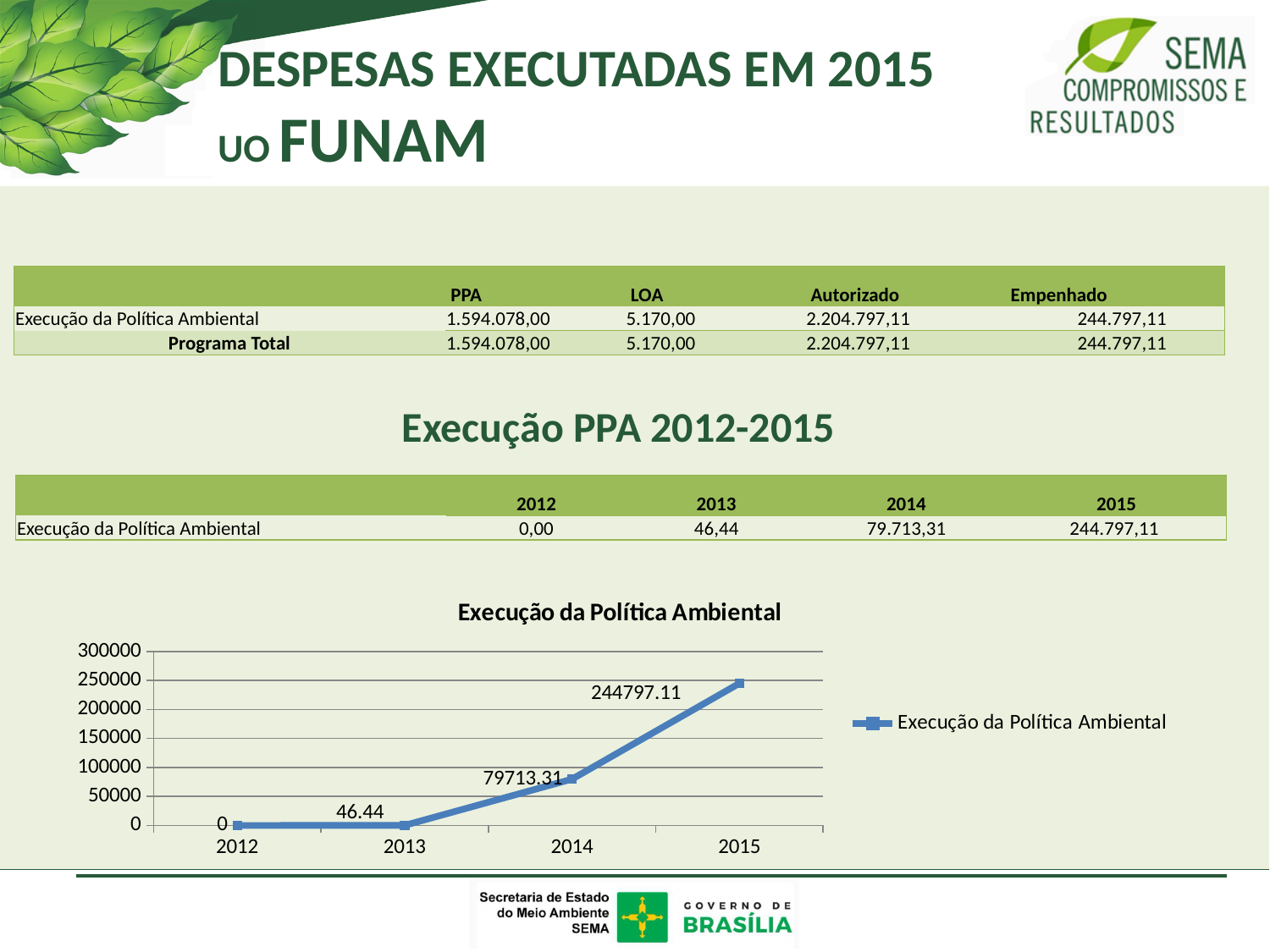
What kind of chart is shown on the slide? line chart How many years are plotted on the x axis of the chart? 4 How many series does the chart legend list? 1 Do the values in the chart rise or fall from 2012 to 2015? rise Is the value for 2015 greater or less than 200000? greater What is the value for 2013 in the chart? 46.44 Which year has the highest value in the chart? 2015 What is the value for 2014 in the chart? 79713.31 What is the value for 2015 in the chart? 244797.11 Which year has the lowest value in the chart? 2012 What is the title of the chart? Execução da Política Ambiental What is the value for 2012 in the chart? 0